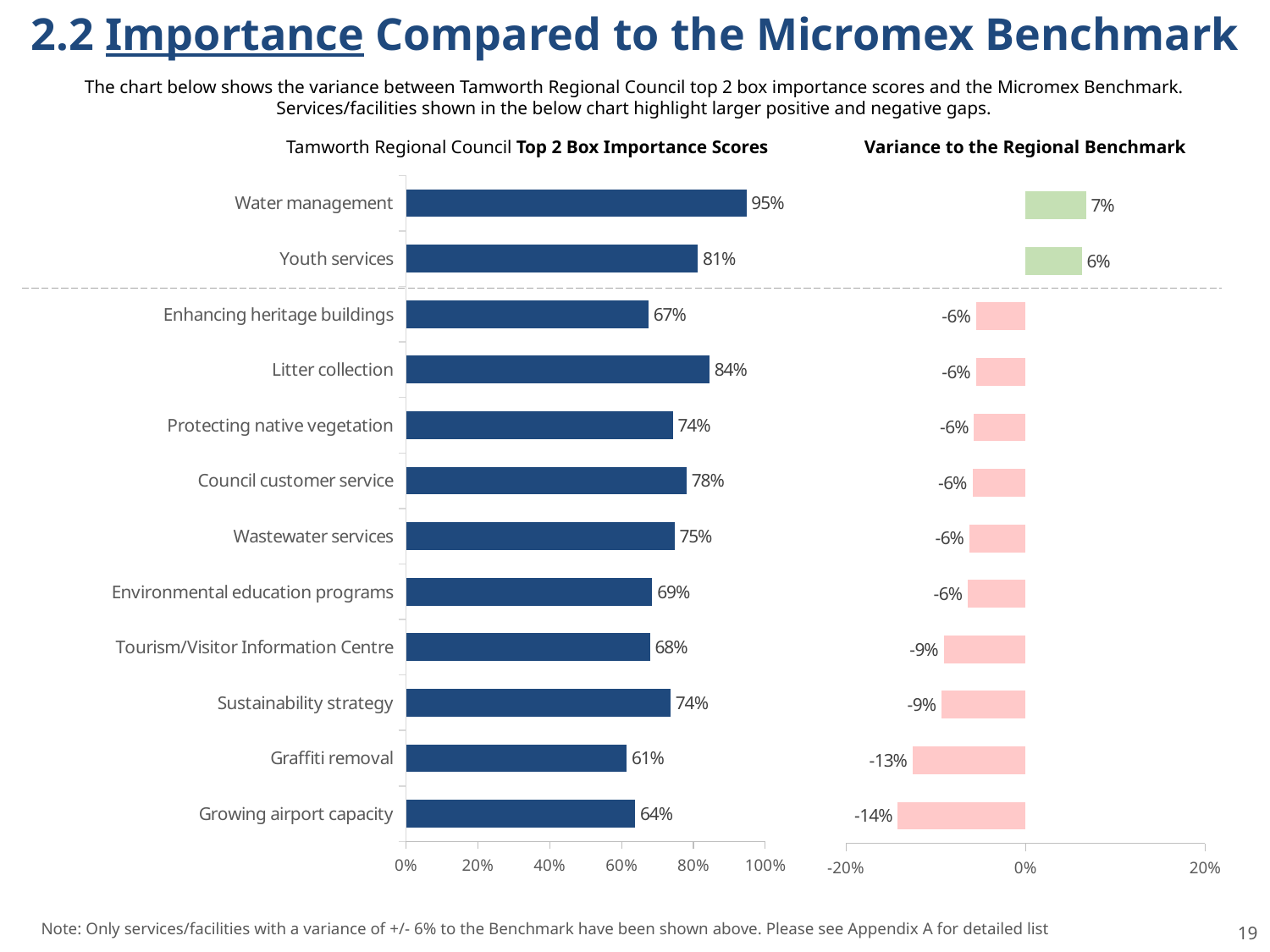
What kind of chart is the Top 2 Box Importance Scores chart? Bar chart In the Top 2 Box Importance Scores chart, which is higher, Council customer service or Wastewater services? Council customer service How many categories are shown in the Top 2 Box Importance Scores chart? 12 In the Top 2 Box Importance Scores chart, which category has the highest score? Water management In the Variance to the Regional Benchmark chart, what is the value for Youth services? 6% In the Top 2 Box Importance Scores chart, is the value for Graffiti removal greater or less than 80%? less In the Variance to the Regional Benchmark chart, what is the value for Growing airport capacity? -14% In the Top 2 Box Importance Scores chart, what is the value for Water management? 95% In the Variance to the Regional Benchmark chart, which category has the largest negative variance? Growing airport capacity In the Top 2 Box Importance Scores chart, which category has the lowest score? Graffiti removal In the Top 2 Box Importance Scores chart, what is the difference between Litter collection and Youth services? 3% In the Variance to the Regional Benchmark chart, how many categories have a positive variance? 2